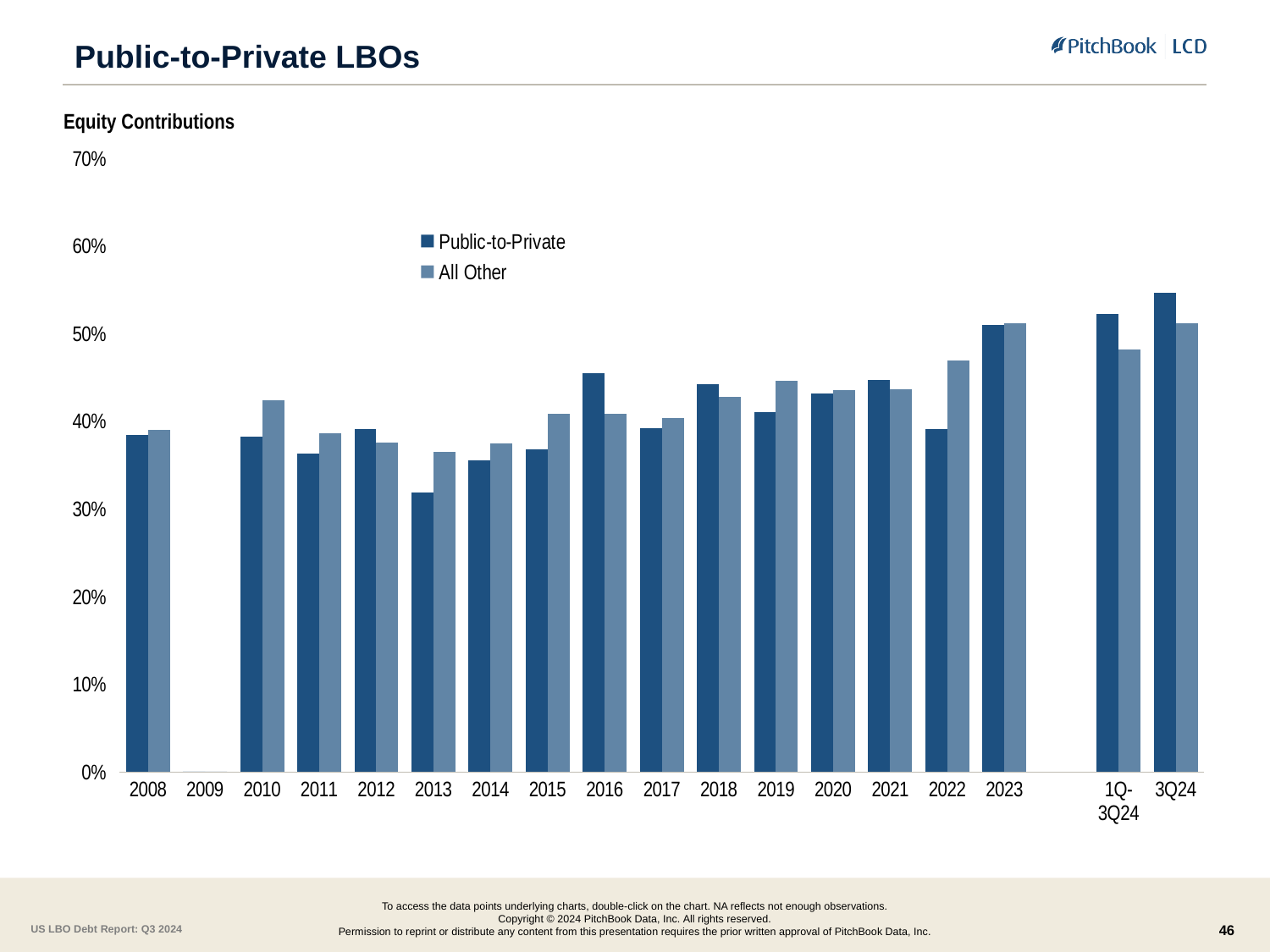
In which year is the Public-to-Private bar the lowest? 2013 How many series does the legend list? 2 How many categories are labelled along the x axis? 18 In 2016, which is larger: the Public-to-Private bar or the All Other bar? Public-to-Private Is the Public-to-Private value for 3Q24 greater or less than 50%? greater Is the All Other value for 2022 greater or less than 40%? greater In which period is the Public-to-Private bar the highest? 3Q24 In 2022, which is larger: the Public-to-Private bar or the All Other bar? All Other What kind of chart is shown on the slide? Bar chart Is the Public-to-Private value for 2013 greater or less than 40%? less Which year on the x axis has no bars plotted? 2009 What are the two series named in the legend? Public-to-Private and All Other